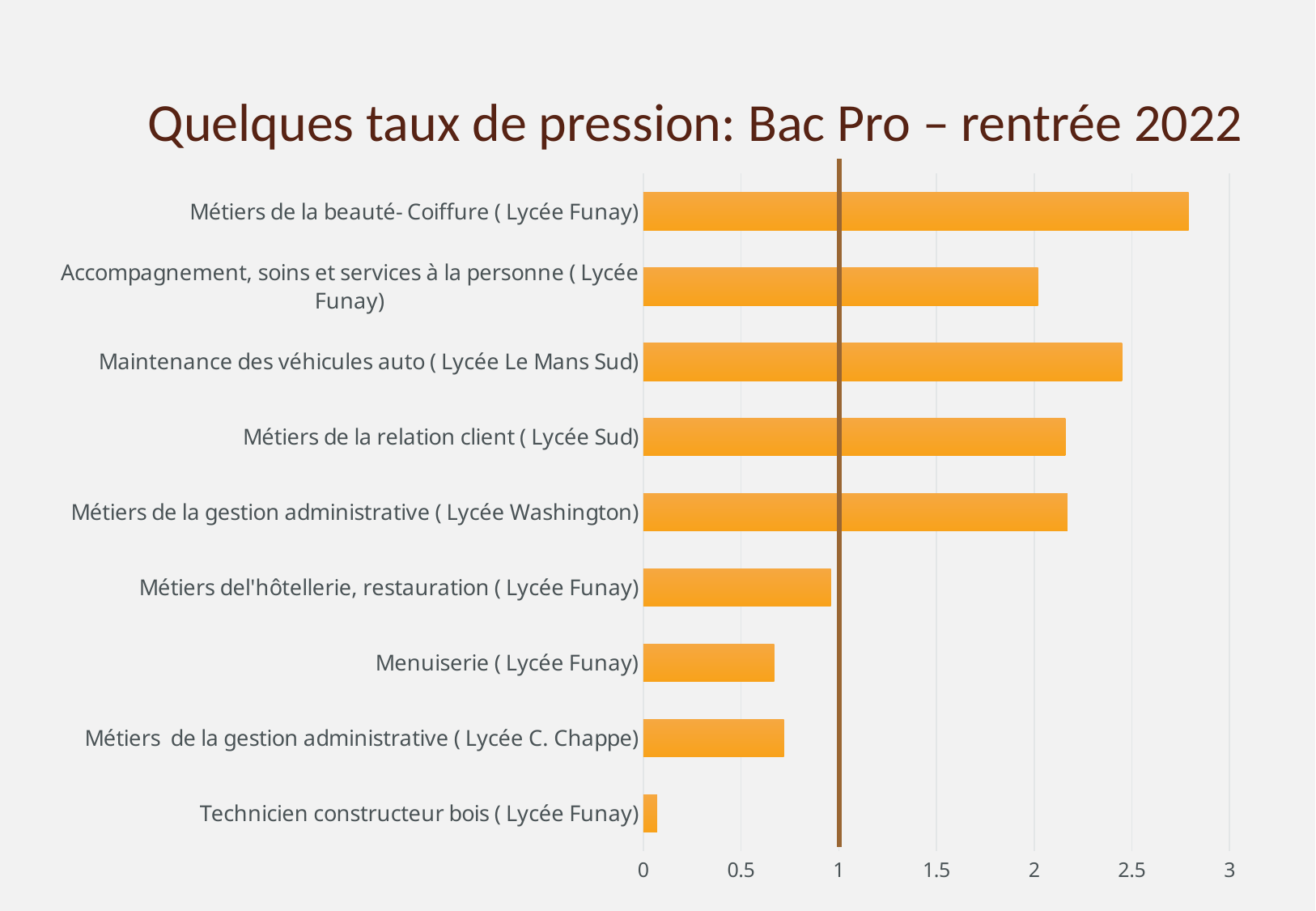
Is the value for Métiers de la beauté- Coiffure ( Lycée Funay) greater or less than 2.5? greater What is the title of the chart? Quelques taux de pression: Bac Pro – rentrée 2022 What kind of chart is shown on the slide? bar chart Is the value for Menuiserie ( Lycée Funay) greater or less than 1? less Which category has the highest value? Métiers de la beauté- Coiffure ( Lycée Funay) How many categories (training programmes) are plotted in the chart? 9 At what x-axis value is the vertical reference line drawn on the chart? 1 Which is larger: the value for Maintenance des véhicules auto ( Lycée Le Mans Sud) or for Accompagnement, soins et services à la personne ( Lycée Funay)? Maintenance des véhicules auto ( Lycée Le Mans Sud) Is the value for Maintenance des véhicules auto ( Lycée Le Mans Sud) greater or less than 2? greater Which is larger: the value for Métiers de la beauté- Coiffure ( Lycée Funay) or for Maintenance des véhicules auto ( Lycée Le Mans Sud)? Métiers de la beauté- Coiffure ( Lycée Funay) Which category has the lowest value? Technicien constructeur bois ( Lycée Funay)